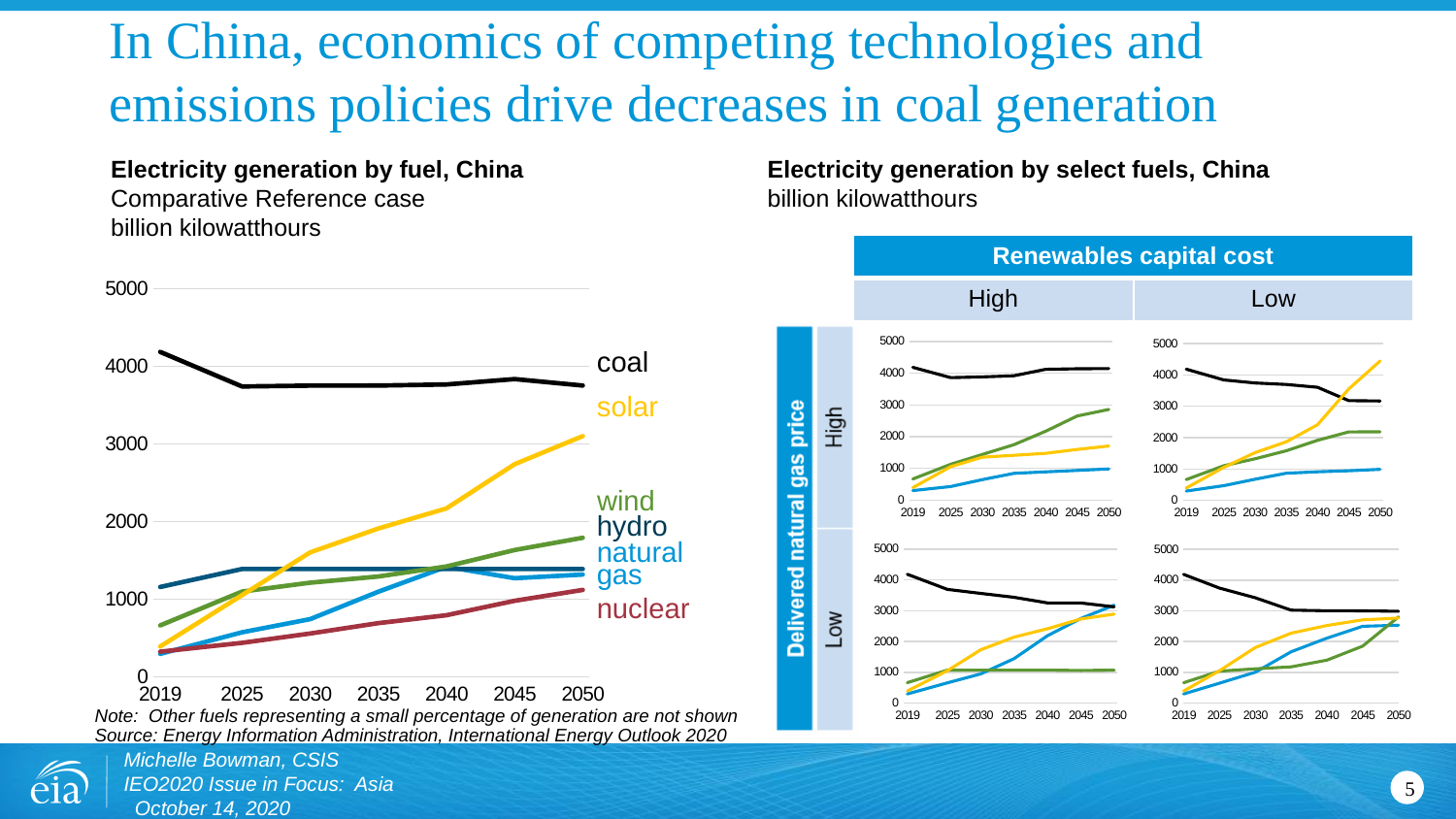
In the left chart, 'Electricity generation by fuel, China', which is larger in 2050, wind or nuclear? wind In the left chart, 'Electricity generation by fuel, China', is the value for solar in 2019 greater or less than 1000? less In the left chart, 'Electricity generation by fuel, China', how many fuel series are plotted? 6 What kind of chart is the left chart, 'Electricity generation by fuel, China'? line chart In the left chart, 'Electricity generation by fuel, China', is the value for coal in 2050 greater or less than 4000? less In the left chart, 'Electricity generation by fuel, China', does solar generation rise or fall from 2019 to 2050? rise In the left chart, 'Electricity generation by fuel, China', is the value for coal in 2019 greater or less than 4000? greater In the left chart, 'Electricity generation by fuel, China', does coal generation rise or fall from 2019 to 2050? fall In the right-hand set of charts, 'Electricity generation by select fuels, China', what are the two levels shown for renewables capital cost? High and Low In the left chart, 'Electricity generation by fuel, China', which fuel has the highest generation in 2050? coal